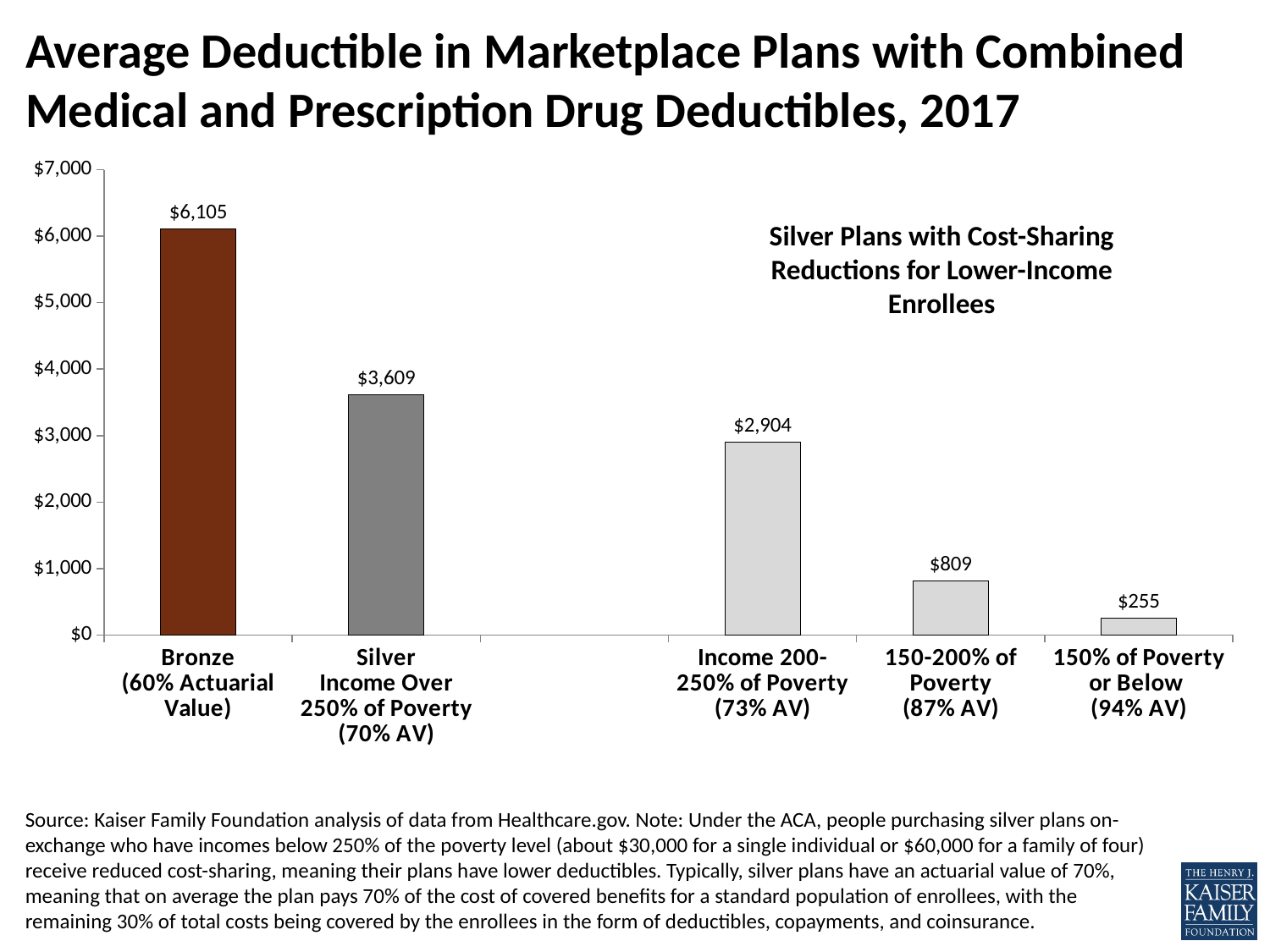
What is the difference between the deductible for 150-200% of Poverty (87% AV) and 150% of Poverty or Below (94% AV)? $554 What is the average deductible for Silver plans for enrollees with income over 250% of poverty (70% AV)? $3,609 Which category has the lowest average deductible? 150% of Poverty or Below (94% AV) Which is larger: the deductible for Silver income over 250% of poverty or for income 200-250% of poverty? Silver income over 250% of poverty What is the difference between the Bronze deductible and the Silver (income over 250% of poverty) deductible? $2,496 Which category has the highest average deductible? Bronze (60% Actuarial Value) How many bars are shown in the chart? 5 What is the average deductible for silver plans for enrollees with income 200-250% of poverty (73% AV)? $2,904 What is the average deductible for Bronze (60% Actuarial Value) plans? $6,105 What is the average deductible for silver plans for enrollees at 150% of poverty or below (94% AV)? $255 What kind of chart is shown on the slide? Bar chart What is the label above the three light grey bars on the right side of the chart? Silver Plans with Cost-Sharing Reductions for Lower-Income Enrollees